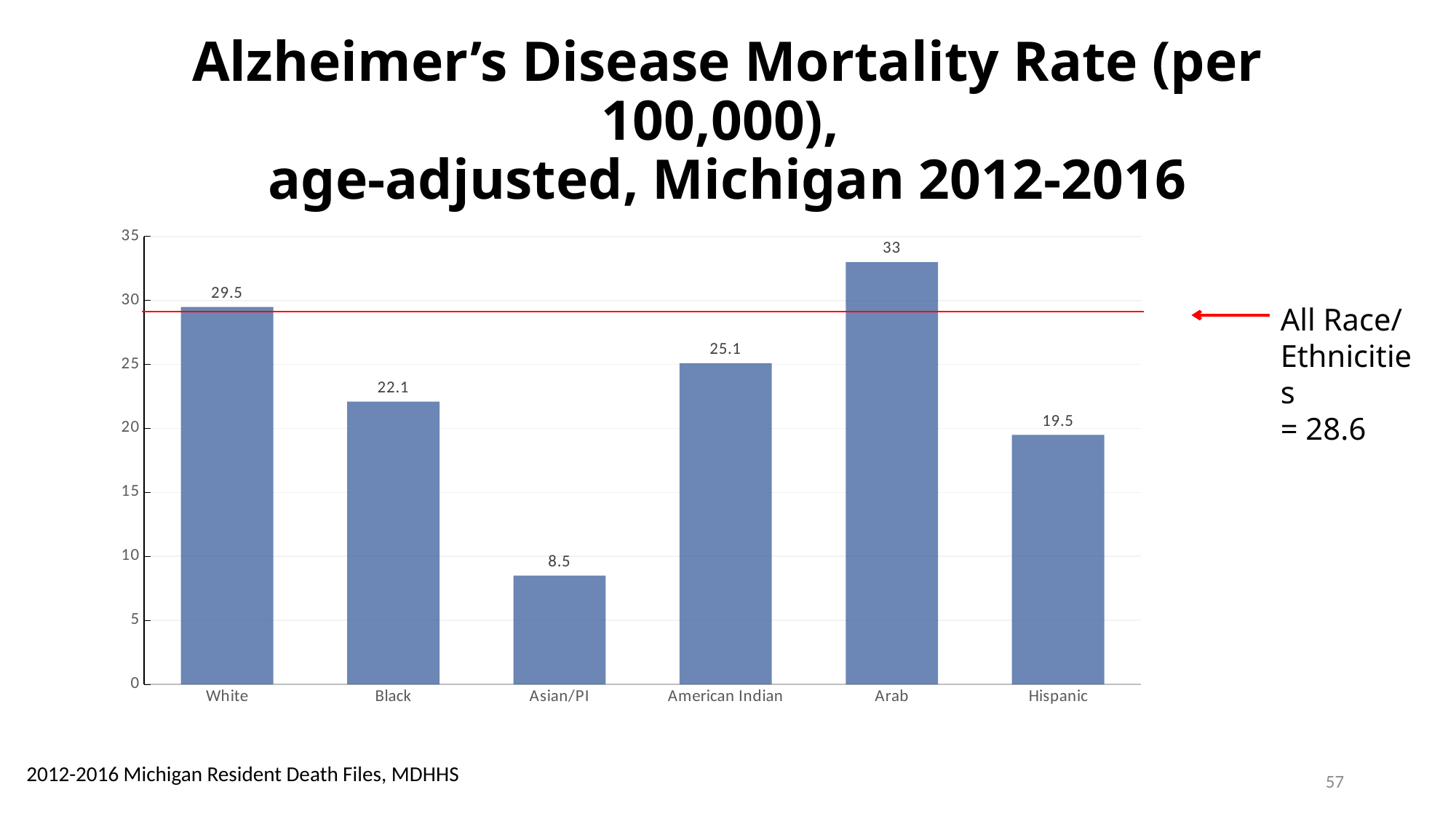
Which group has a higher mortality rate, Black or American Indian? American Indian What is the difference between the mortality rates for the Arab and White groups? 3.5 How many race/ethnicity groups are shown on the chart? 6 What is the difference between the mortality rates for the Black and Hispanic groups? 2.6 What is the Alzheimer's disease mortality rate for the Arab group? 33 What is the Alzheimer's disease mortality rate for the Hispanic group? 19.5 What kind of chart is shown on the slide? Bar chart Which race/ethnicity group has the lowest Alzheimer's disease mortality rate? Asian/PI What is the Alzheimer's disease mortality rate for the White group? 29.5 Which race/ethnicity group has the highest Alzheimer's disease mortality rate? Arab What is the Alzheimer's disease mortality rate for the Asian/PI group? 8.5 What is the mortality rate for all race/ethnicities combined, as indicated by the red line? 28.6